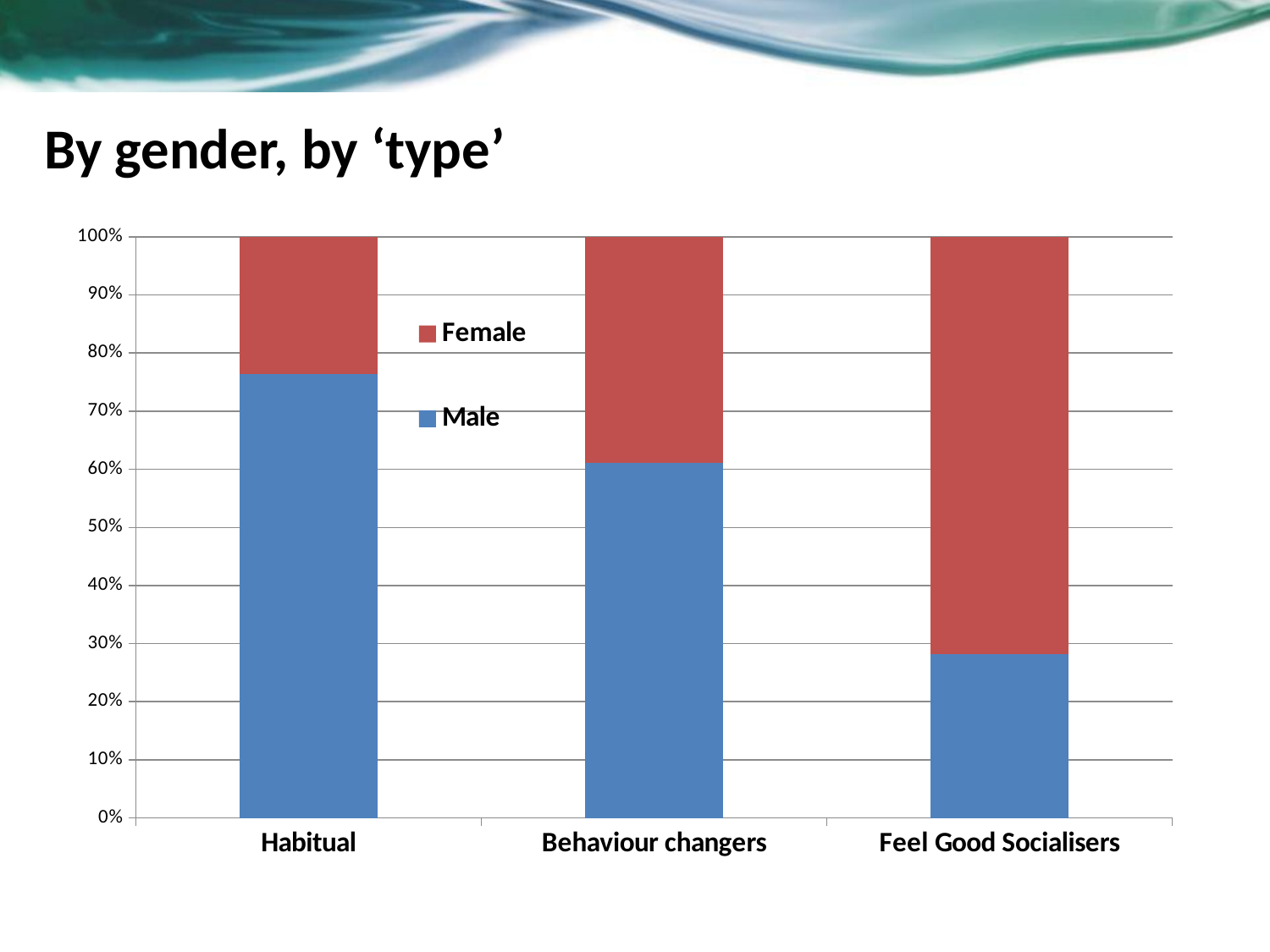
How many categories are shown on the x axis of the chart? 3 What kind of chart is shown on the slide? Stacked bar chart How many series does the chart's legend list? 2 Which category has the highest Female share? Feel Good Socialisers Is the Male share for Feel Good Socialisers greater or less than 30%? less Which is larger, the Male share for Habitual or the Male share for Behaviour changers? Habitual Does the Male share rise or fall moving from Habitual to Feel Good Socialisers along the x axis? fall Which colour represents Female in the chart? Red Is the Male share for Habitual greater or less than 70%? greater Which category has the highest Male share? Habitual Which category has the lowest Male share? Feel Good Socialisers